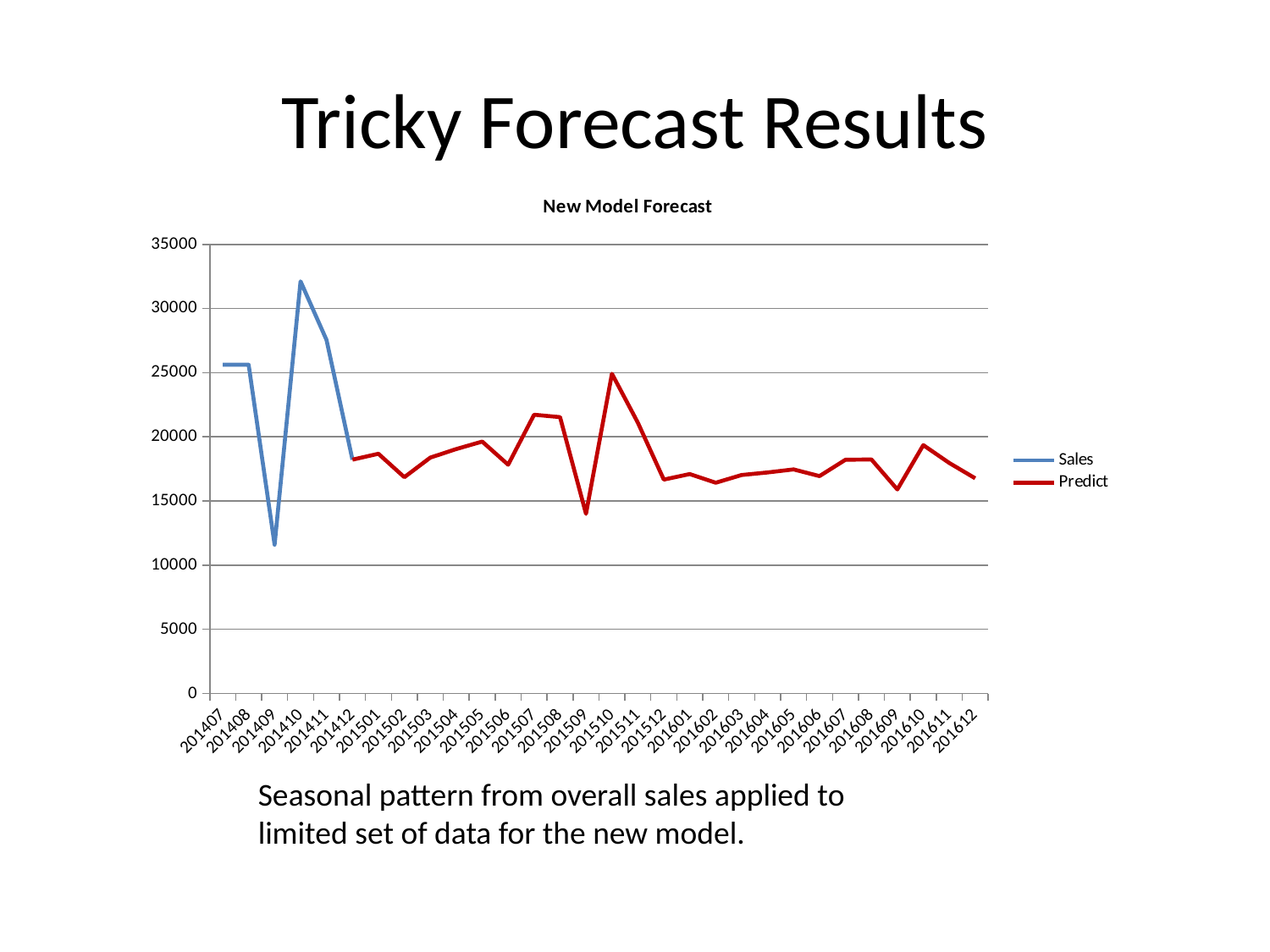
Is the Predict value for 201509 greater or less than 15000? less How many series does the legend list? 2 In which period does the Predict series reach its lowest value? 201509 In which period does the Sales series reach its highest value? 201410 How many periods are shown along the x axis? 30 In which period does the Sales series reach its lowest value? 201409 In which period does the Predict series reach its highest value? 201510 Is the Sales value for 201410 greater or less than 30000? greater What is the title of the chart? New Model Forecast Which is larger: the Predict value for 201507 or the Predict value for 201512? 201507 What kind of chart is shown on the slide? line chart Is the Sales value for 201409 greater or less than 15000? less